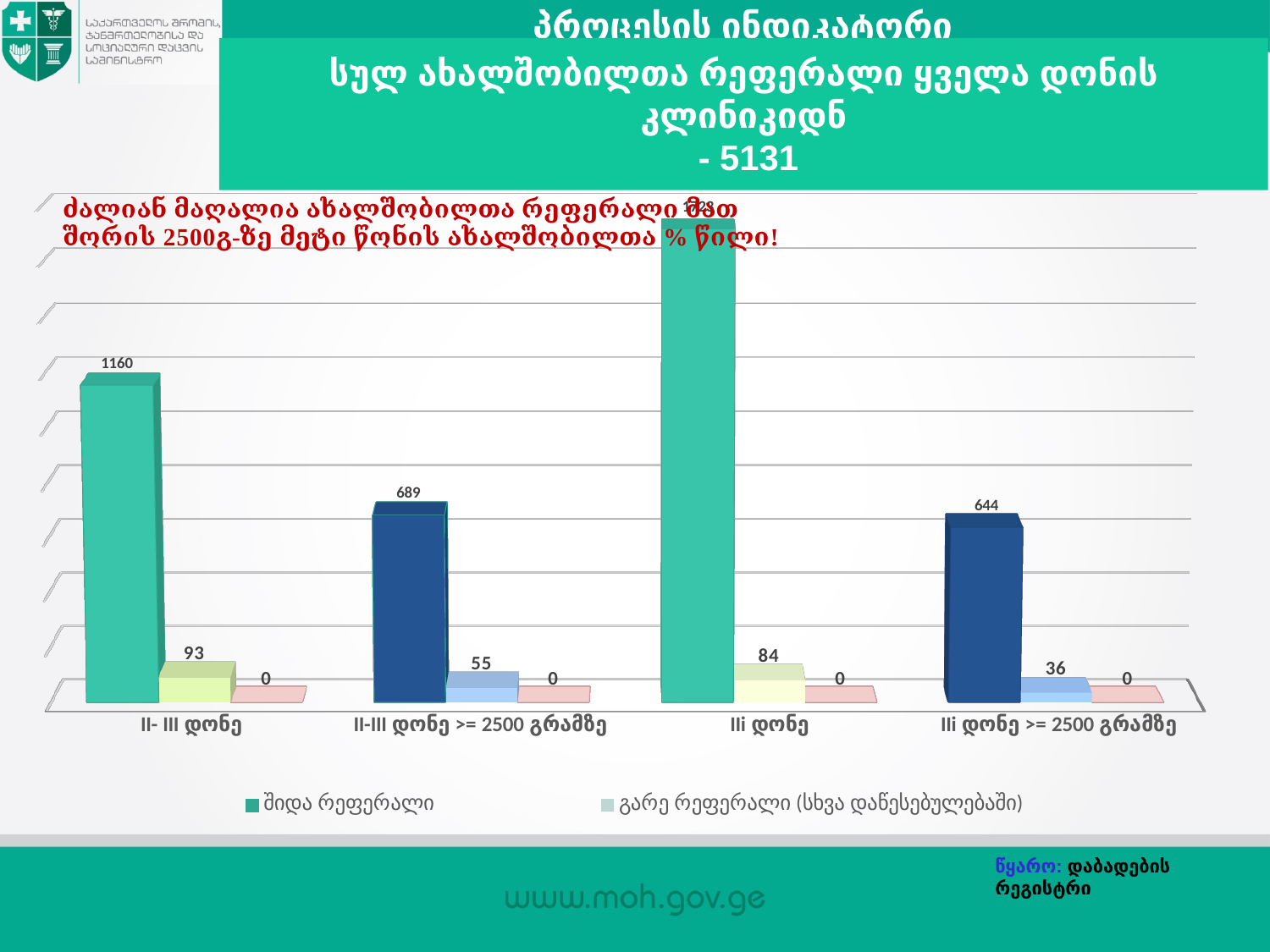
What total number is printed in the chart title on the slide? 5131 How many categories are shown along the x axis of the chart? 4 What is the difference between the შიდა რეფერალი values for II- III დონე and II-III დონე >= 2500 გრამზე? 471 What is the value of the third (pink) bar for the category II- III დონე? 0 What is the value of გარე რეფერალი (სხვა დაწესებულებაში) for the category II-III დონე >= 2500 გრამზე? 55 Which category has the tallest შიდა რეფერალი bar? III დონე How many series does the chart legend list? 2 What kind of chart is shown on the slide? bar chart What is the value of შიდა რეფერალი for the category III დონე >= 2500 გრამზე? 644 Which is larger: the შიდა რეფერალი value for II-III დონე >= 2500 გრამზე or for III დონე >= 2500 გრამზე? II-III დონე >= 2500 გრამზე What is the value of გარე რეფერალი (სხვა დაწესებულებაში) for the category III დონე? 84 What is the value of შიდა რეფერალი for the category II- III დონე? 1160